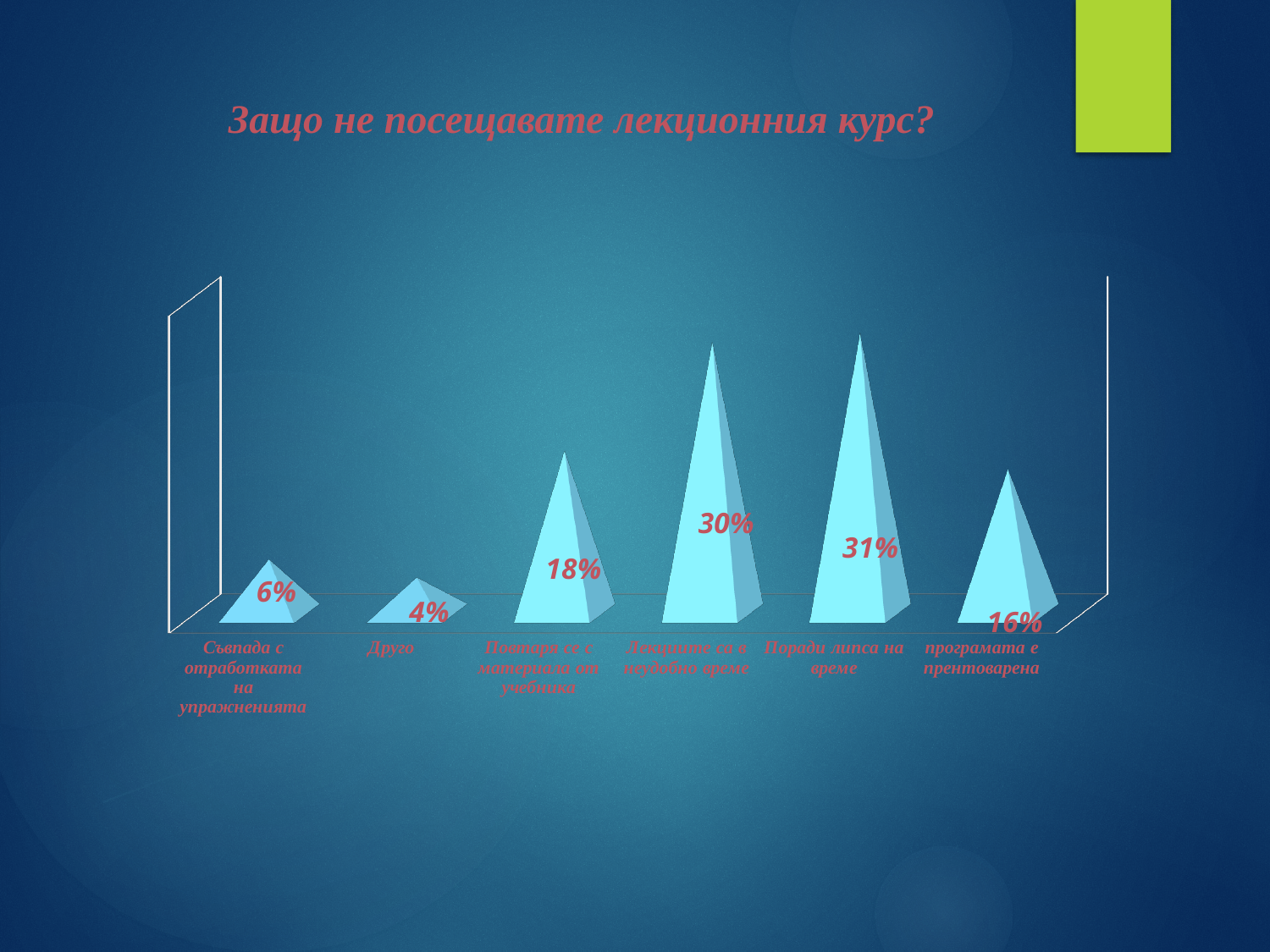
Which category has the lowest value? Друго What is the difference between the values for "Лекциите са в неудобно време" and "Повтаря се с материала от учебника"? 12% What is the value for "Лекциите са в неудобно време"? 30% What is the value for "програмата е претоварена"? 16% What is the value for "Поради липса на време"? 31% How many categories are shown in the chart? 6 What is the value for "Съвпада с отработката на упражненията"? 6% What is the title of the chart? Защо не посещавате лекционния курс? What is the value for "Друго"? 4% Which is larger, the value for "програмата е претоварена" or the value for "Съвпада с отработката на упражненията"? програмата е претоварена What kind of chart is shown on the slide? Bar chart Which category has the highest value? Поради липса на време